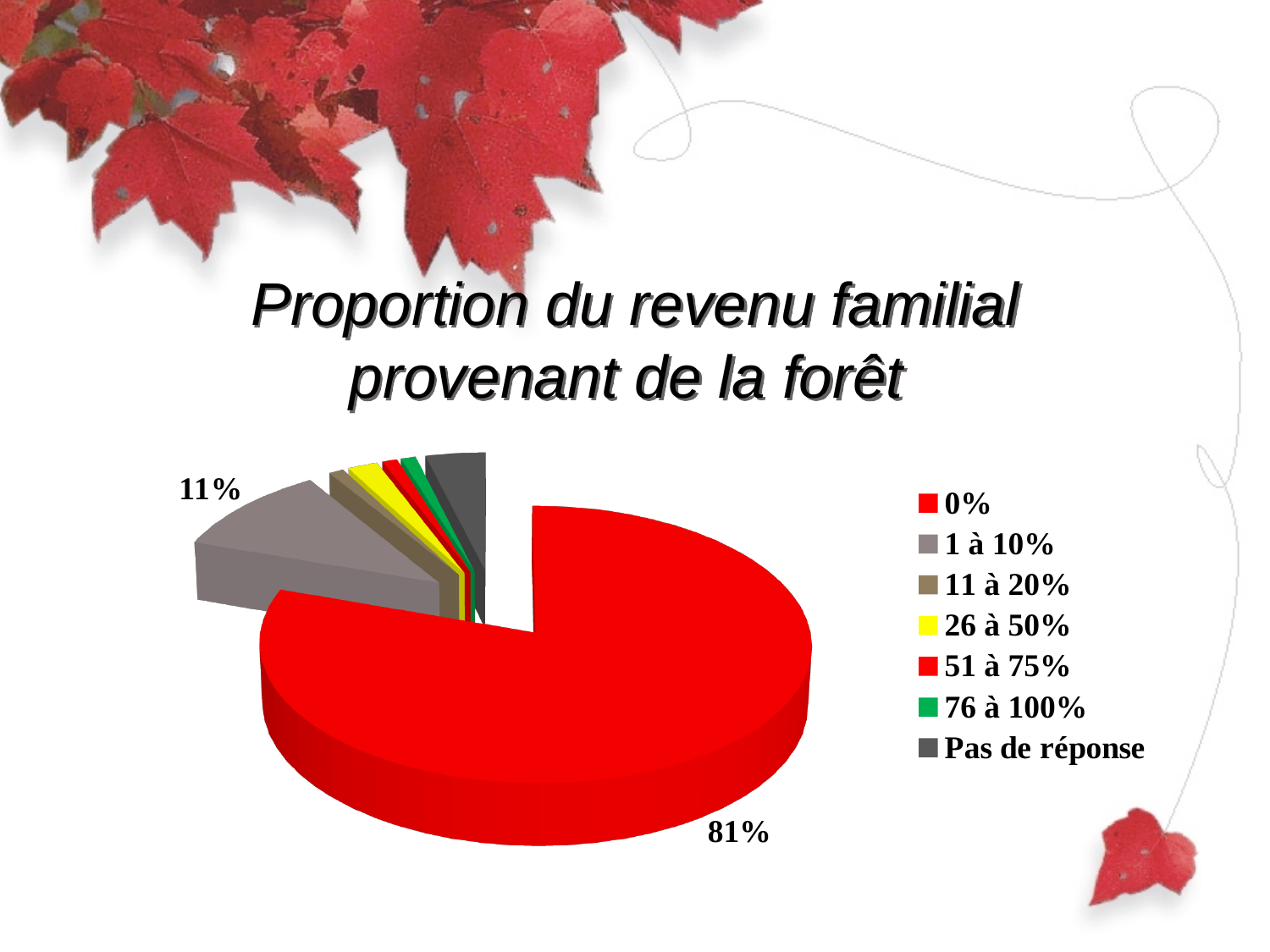
What percentage is shown for the "0%" category? 81% What percentage is shown for the "1 à 10%" category? 11% Which is larger, the "0%" slice or the "1 à 10%" slice? 0% What colour is the slice for the "0%" category? red What share of the pie does the "0%" category represent? 81% What is the title of the chart? Proportion du revenu familial provenant de la forêt Which category has the largest slice of the pie? 0% What kind of chart is shown on the slide? pie chart How many categories does the legend list? 7 Which category is represented by the grey slice labelled 11%? 1 à 10% What is the difference between the "0%" slice and the "1 à 10%" slice? 70 percentage points